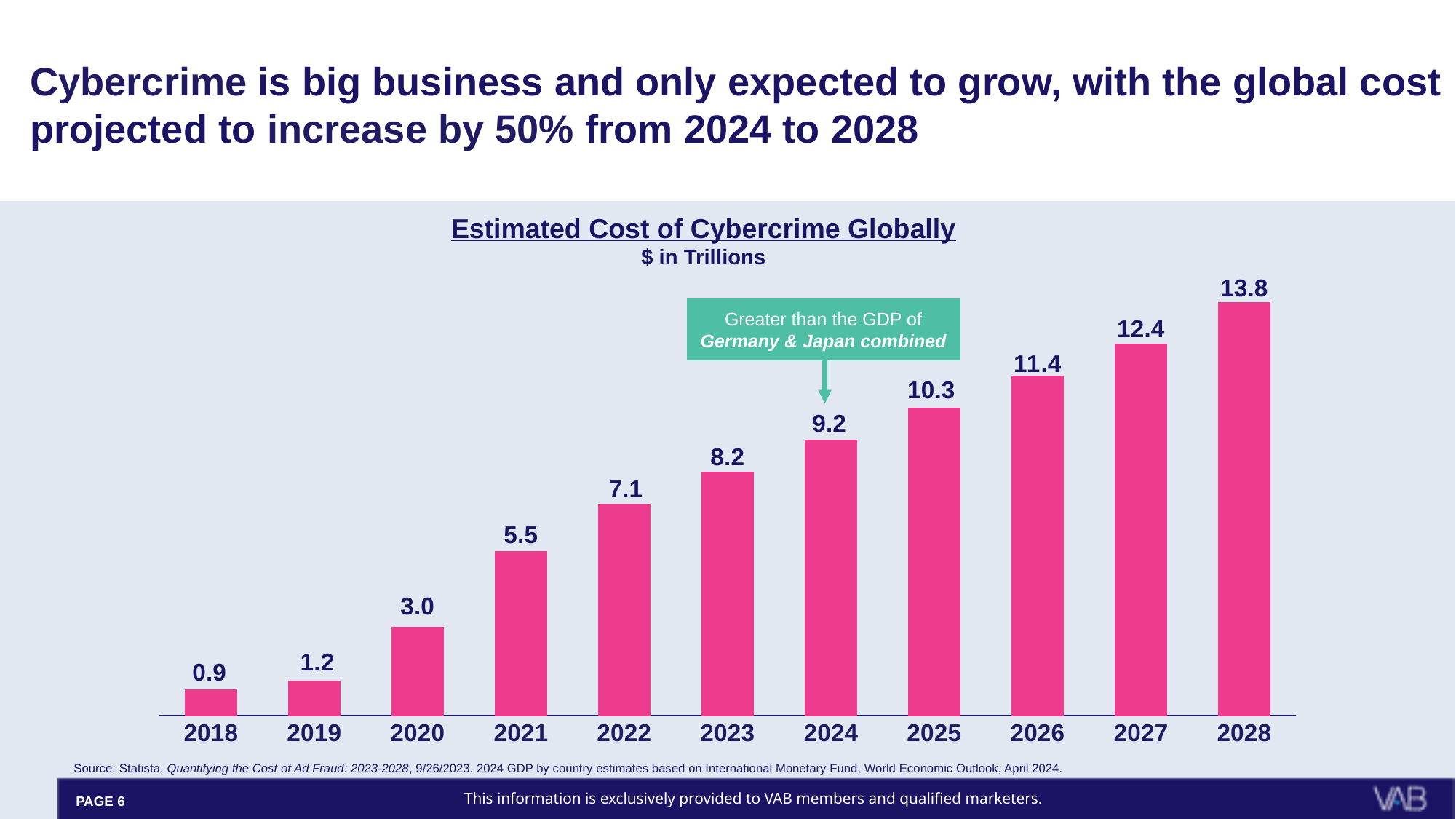
What is the difference between the estimated cost of cybercrime in 2020 and in 2019? 1.8 How many years are shown on the chart? 11 What kind of chart is shown on the slide? Bar chart What is the estimated cost of cybercrime globally for 2021? 5.5 What is the difference between the estimated cost of cybercrime in 2028 and in 2024? 4.6 Which year has the lowest estimated cost of cybercrime? 2018 Which year has the highest estimated cost of cybercrime? 2028 What is the estimated cost of cybercrime globally for 2024? 9.2 What is the estimated cost of cybercrime globally for 2018? 0.9 Which year has a higher estimated cost of cybercrime, 2022 or 2025? 2025 Do the values rise or fall from 2018 to 2028? Rise What unit is the chart's data expressed in, according to the subtitle? $ in Trillions